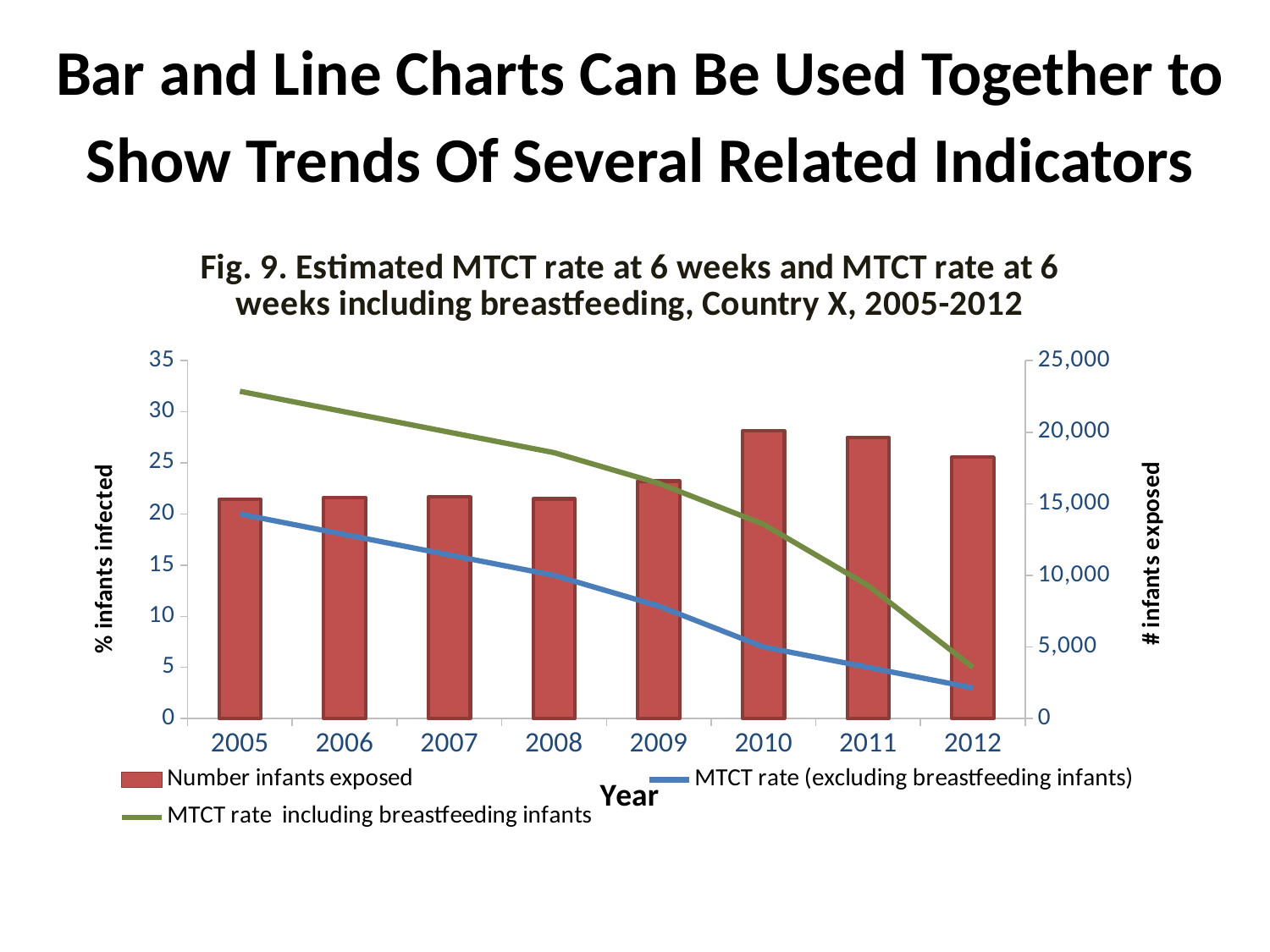
Does the MTCT rate including breastfeeding infants rise or fall from 2005 to 2012? Fall In which year is the MTCT rate including breastfeeding infants lowest? 2012 In which year is the number of infants exposed highest? 2010 How many series does the legend list? 3 Is the MTCT rate (excluding breastfeeding infants) in 2012 greater or less than 5? less In 2005, which is larger: the MTCT rate including breastfeeding infants or the MTCT rate excluding breastfeeding infants? MTCT rate including breastfeeding infants Does the MTCT rate (excluding breastfeeding infants) rise or fall from 2005 to 2012? Fall Is the MTCT rate including breastfeeding infants in 2005 greater or less than 30? greater Is the number of infants exposed in 2012 greater or less than 15,000? greater In which year is the MTCT rate including breastfeeding infants highest? 2005 What kind of chart is shown on the slide? A combined bar and line chart How many years are shown on the x axis? 8